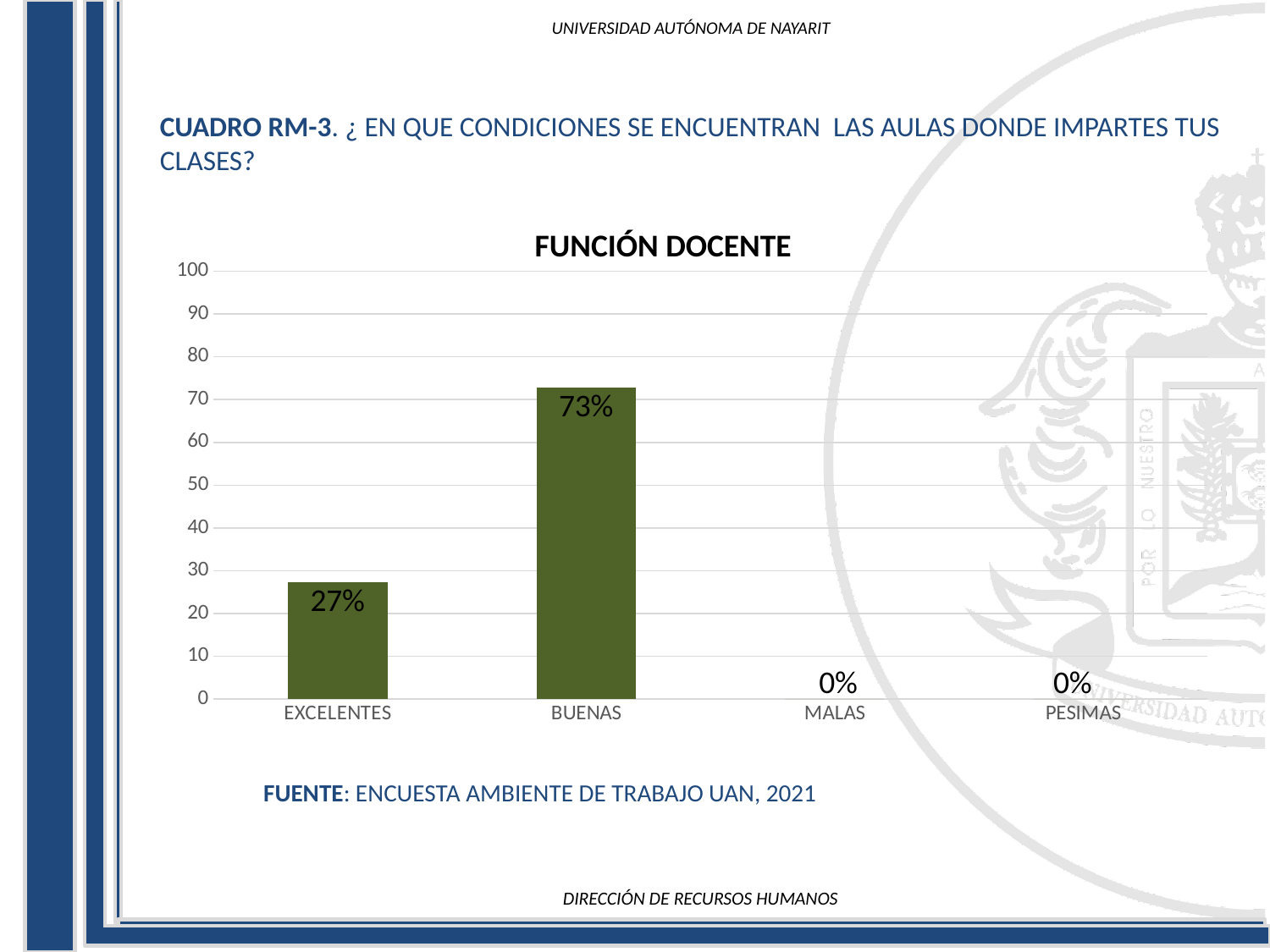
Which is larger, the value for EXCELENTES or the value for BUENAS? BUENAS Which category has the highest value? BUENAS What is the value for BUENAS? 73% What is the difference between the values for BUENAS and EXCELENTES? 46% What is the value for MALAS? 0% What is the title of the chart? FUNCIÓN DOCENTE What kind of chart is shown on the slide? bar chart Is the value for EXCELENTES greater or less than 30? less Is the value for BUENAS greater or less than 70? greater What is the value for PESIMAS? 0% How many categories are shown on the x axis? 4 What is the value for EXCELENTES? 27%